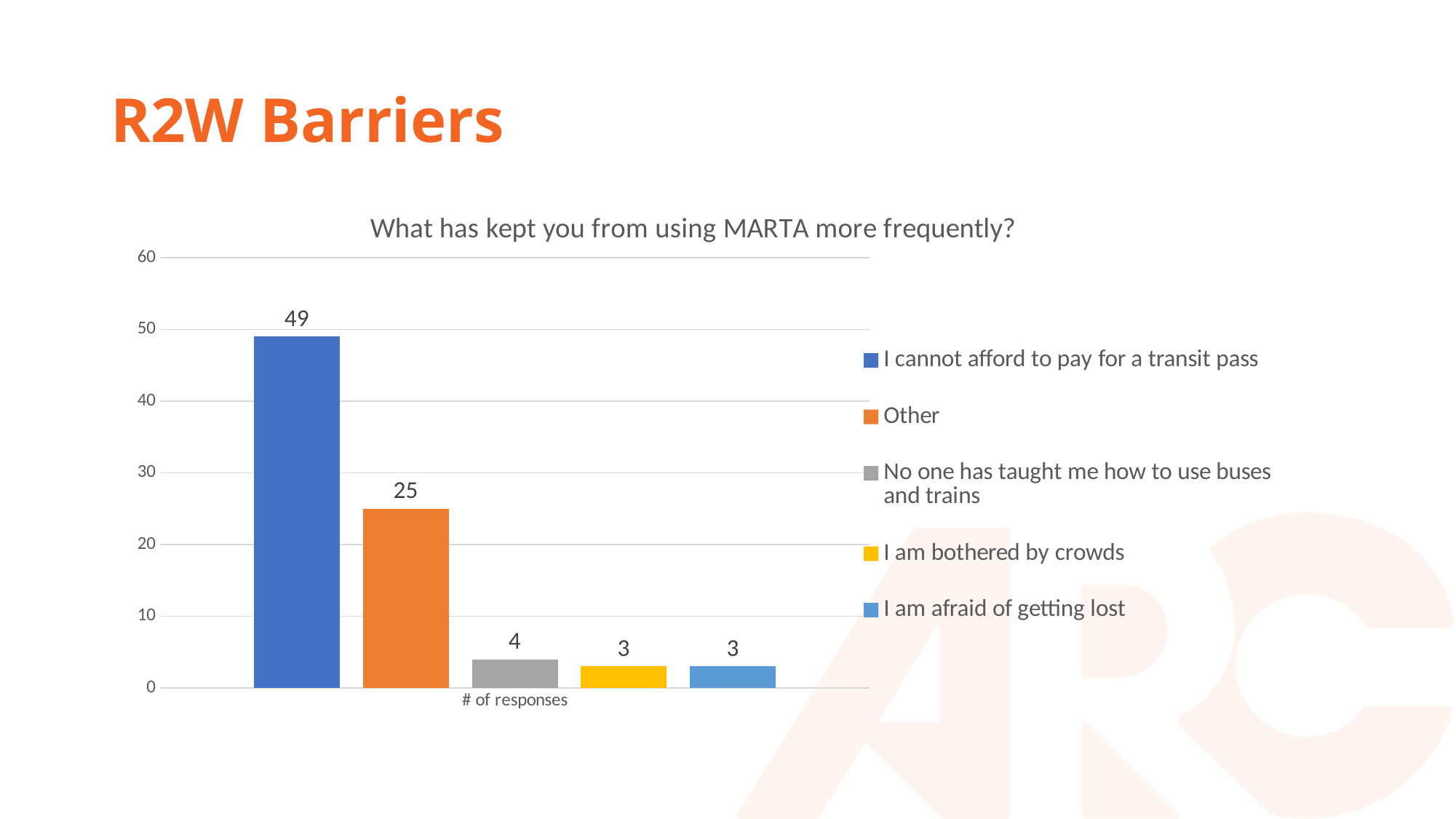
What is the title of the chart? What has kept you from using MARTA more frequently? How many responses were there for "I am bothered by crowds"? 3 What colour is the bar for "I am bothered by crowds"? Yellow Which received more responses, "Other" or "No one has taught me how to use buses and trains"? Other How many responses were there for "Other"? 25 What kind of chart is shown on the slide? Bar chart What is the total number of responses across all five barriers? 84 How many series does the legend list? 5 How many responses were there for "No one has taught me how to use buses and trains"? 4 How many responses were there for "I cannot afford to pay for a transit pass"? 49 Which barrier received the most responses? I cannot afford to pay for a transit pass What is the difference in responses between "I cannot afford to pay for a transit pass" and "Other"? 24